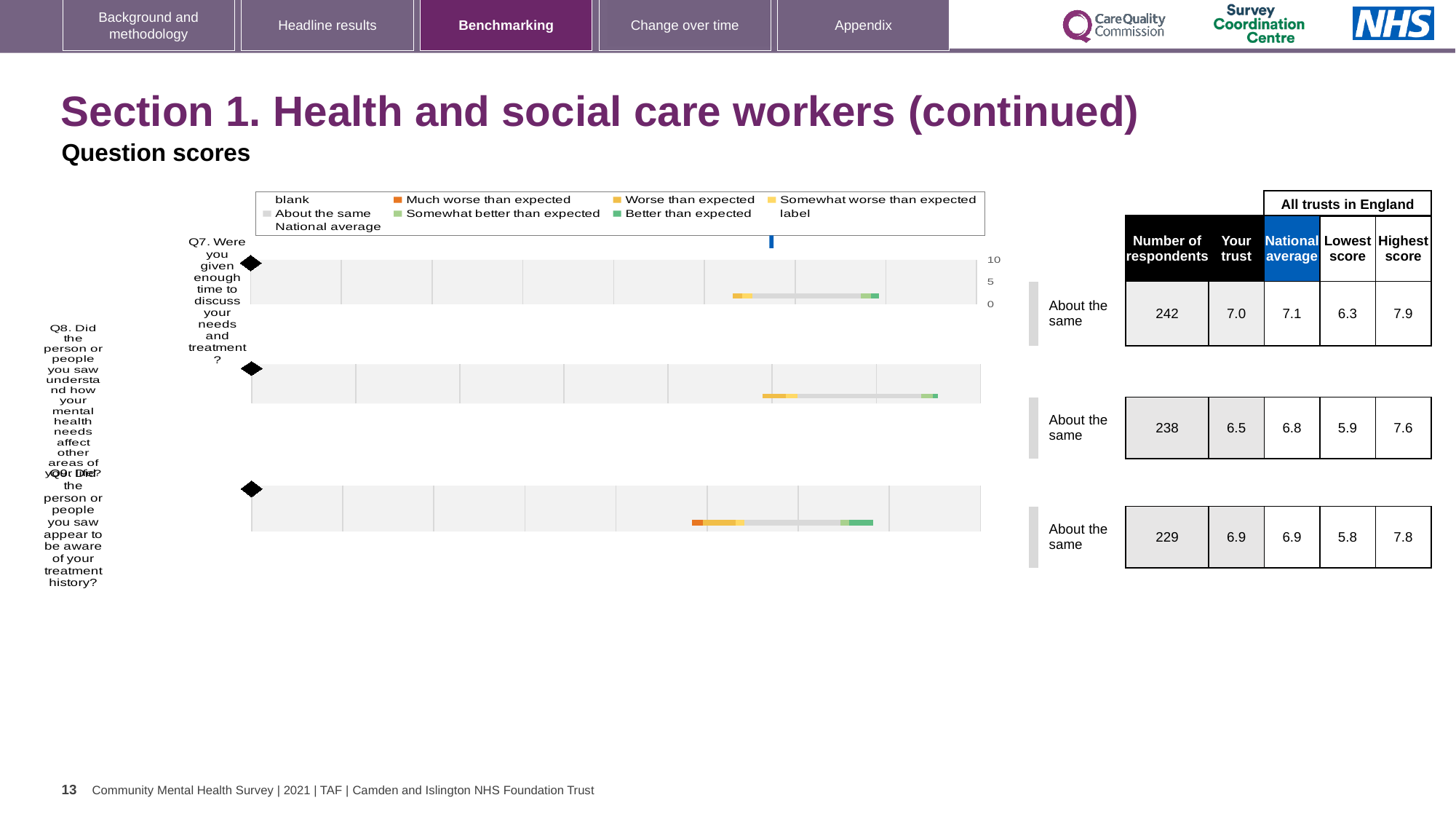
What is the lowest score across all trusts in England for Q9? 5.8 What benchmark category is shown next to the chart for Q8? About the same According to the table, how many respondents answered Q7 (Were you given enough time to discuss your needs and treatment?)? 242 What is the national average score for Q9 (Did the person or people you saw appear to be aware of your treatment history?)? 6.9 Which question has the smallest number of respondents? Q9 How many questions (Q7, Q8, Q9) are plotted on this slide? 3 For Q8, what is the difference between the highest score and the lowest score across all trusts in England? 1.7 What is the highest score across all trusts in England for Q7? 7.9 For Q7, which is larger: the 'Your trust' score or the national average? National average What kind of chart is used to show the question scores on this slide? bar chart What is the 'Your trust' score for Q8 (Did the person or people you saw understand how your mental health needs affect other areas of your life?)? 6.5 Which question has the largest number of respondents? Q7